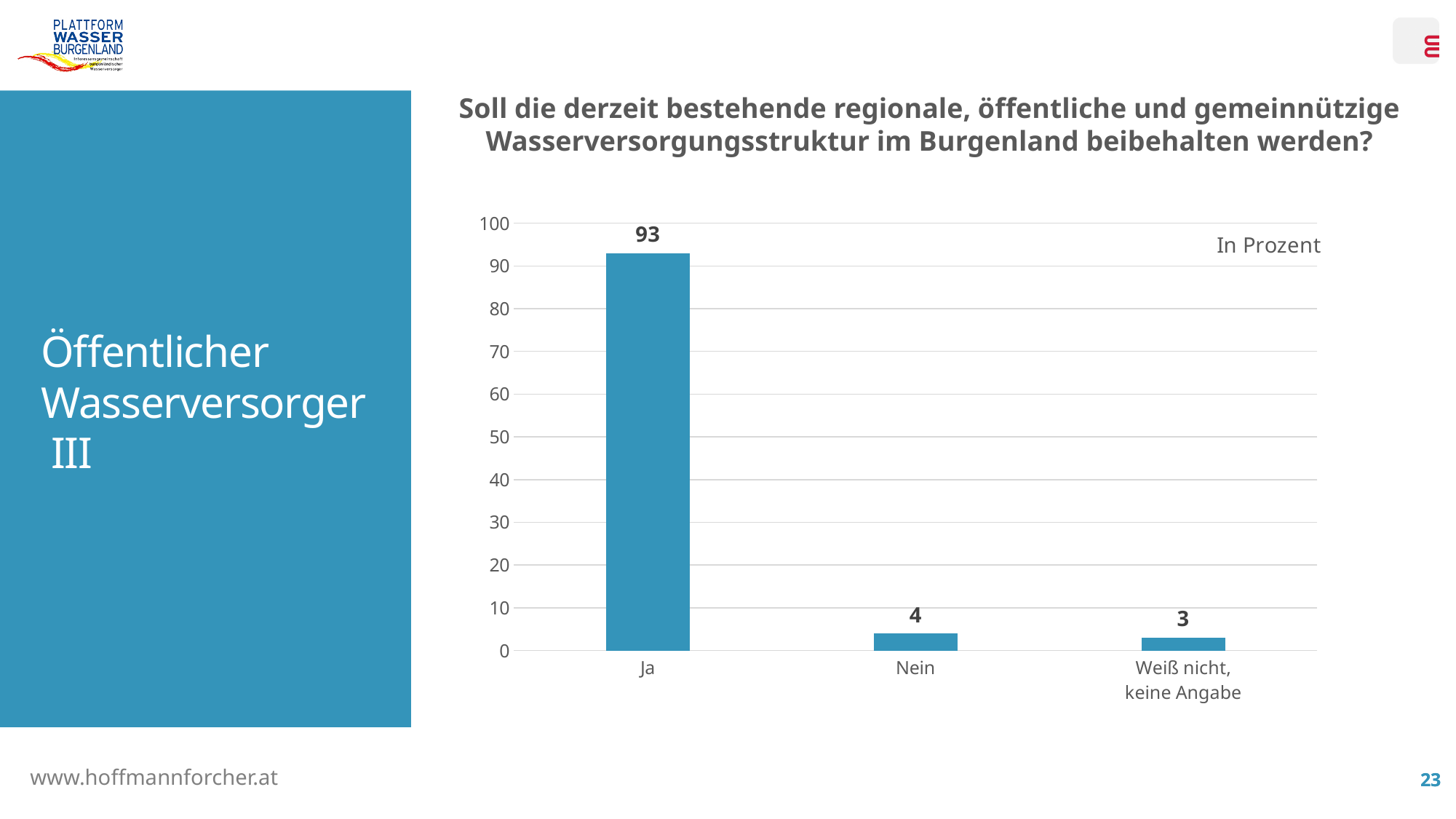
What is the difference between the values for "Ja" and "Nein"? 89 Which is larger, the value for "Nein" or the value for "Weiß nicht, keine Angabe"? Nein What is the value for "Ja"? 93 Which category has the highest value? Ja Is the value for "Ja" greater or less than 90? greater What is the difference between the values for "Nein" and "Weiß nicht, keine Angabe"? 1 In what unit are the values given, according to the note in the chart? In Prozent Which category has the lowest value? Weiß nicht, keine Angabe What kind of chart is shown on the slide? Bar chart How many categories are shown on the x axis? 3 What is the value for "Nein"? 4 What is the value for "Weiß nicht, keine Angabe"? 3